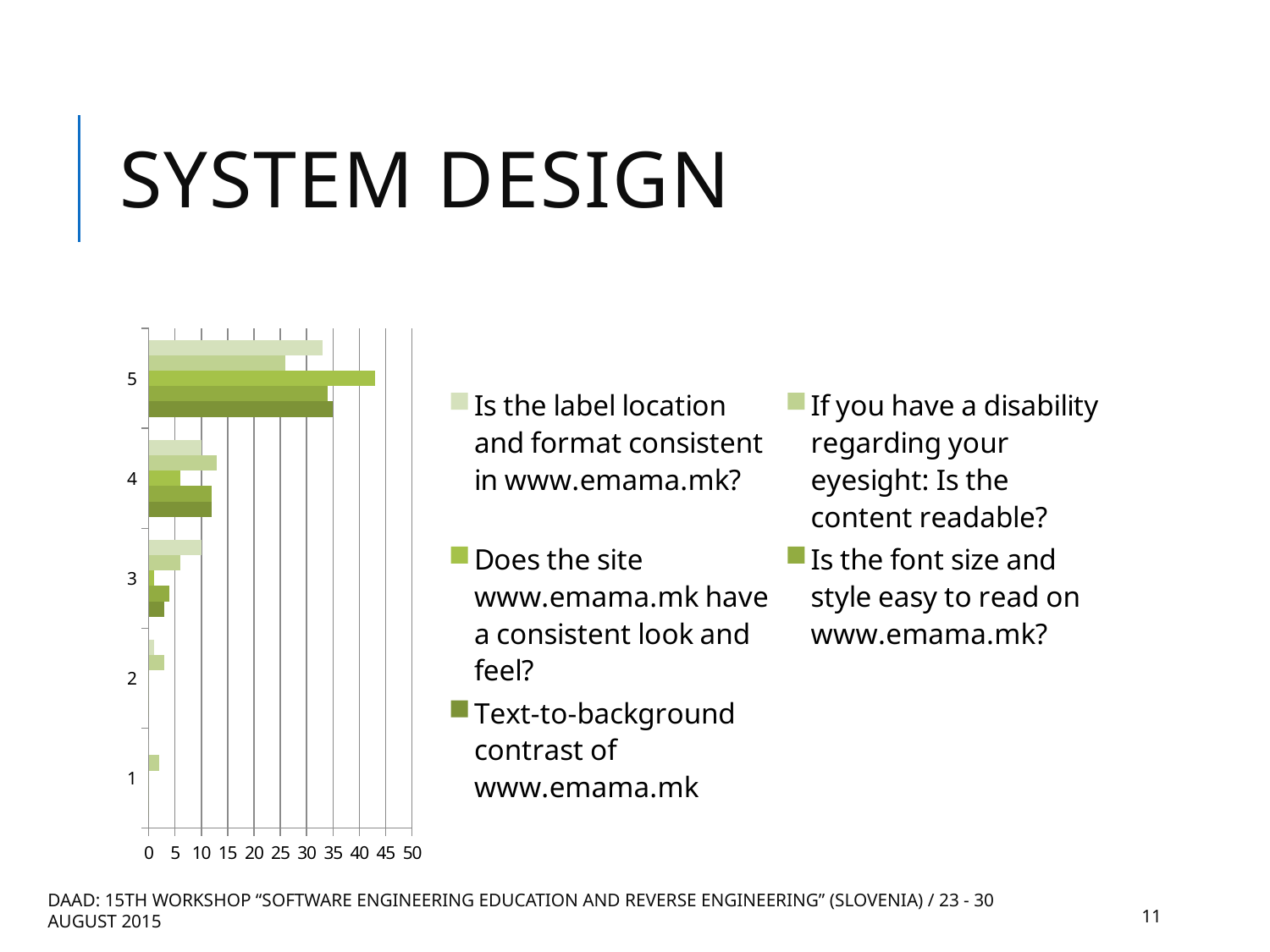
How many categories are shown on the vertical axis of the chart? 5 Do the bar lengths generally rise or fall as the category goes from 1 to 5? rise How many series does the legend list? 5 What type of chart is shown on the slide? Bar chart What is the maximum value shown on the horizontal axis? 50 Is the longest bar in category 4 greater or less than 15? less Which legend entry is shown in the darkest green colour? Text-to-background contrast of www.emama.mk Which category has larger bars, category 4 or category 5? 5 Which category (rating) has the longest bars overall? 5 Is the longest bar in category 1 greater or less than 5? less Is the longest bar in category 2 greater or less than 5? less